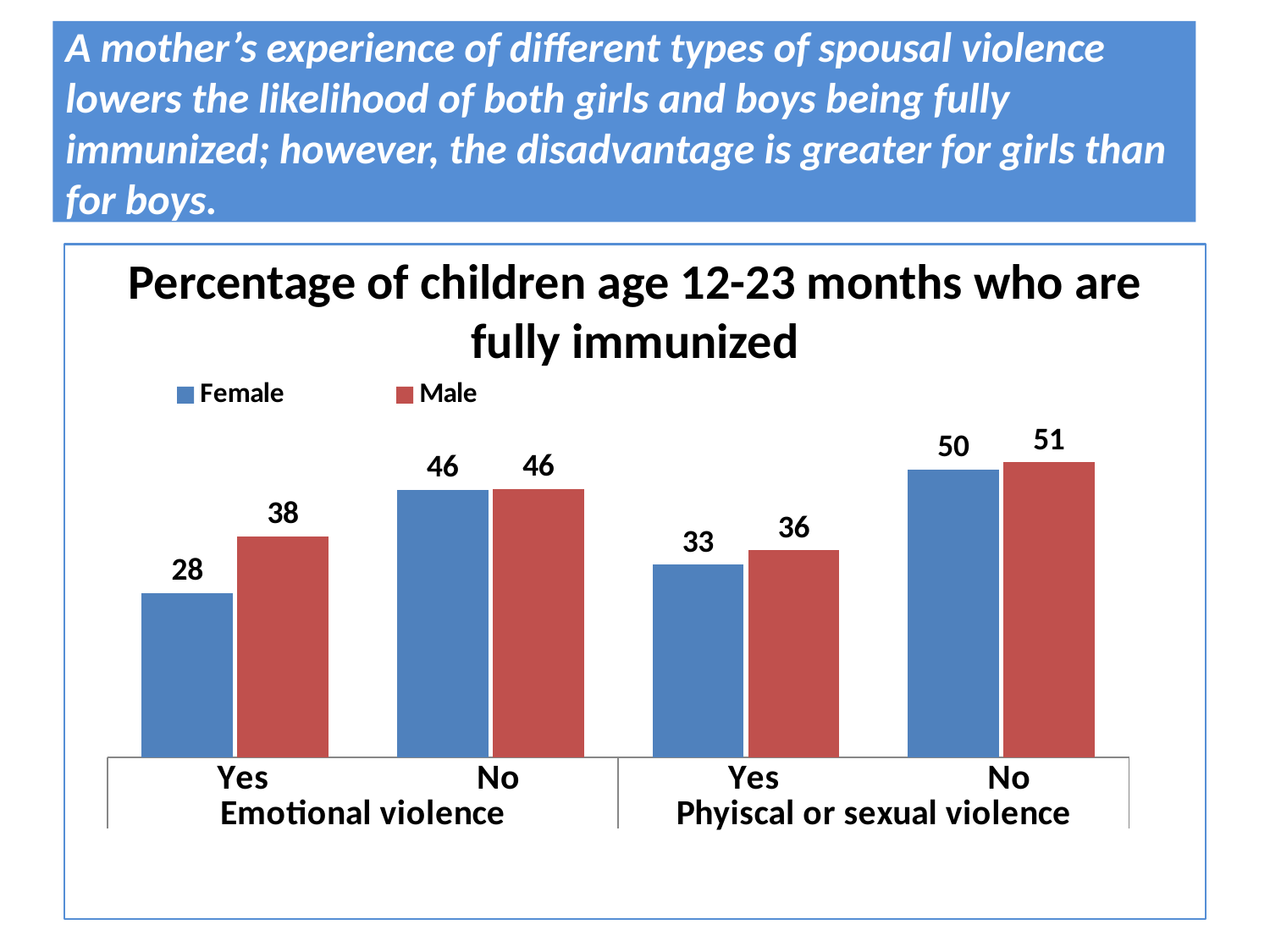
Which is larger, the Female value for 'Yes' under Emotional violence or the Female value for 'Yes' under Physical or sexual violence? Yes under Physical or sexual violence What is the title of the chart? Percentage of children age 12-23 months who are fully immunized What is the difference between the Female values for 'No' and 'Yes' under Physical or sexual violence? 17 Which category has the highest Male value? No, Physical or sexual violence What is the Female value for 'Yes' under Physical or sexual violence? 33 What is the Male value for 'Yes' under Emotional violence? 38 What kind of chart is shown? Bar chart What is the Male value for 'No' under Physical or sexual violence? 51 Which category has the lowest Female value? Yes, Emotional violence How many series does the legend list? 2 What is the Female value for 'Yes' under Emotional violence? 28 What is the difference between the Male and Female values for 'Yes' under Emotional violence? 10